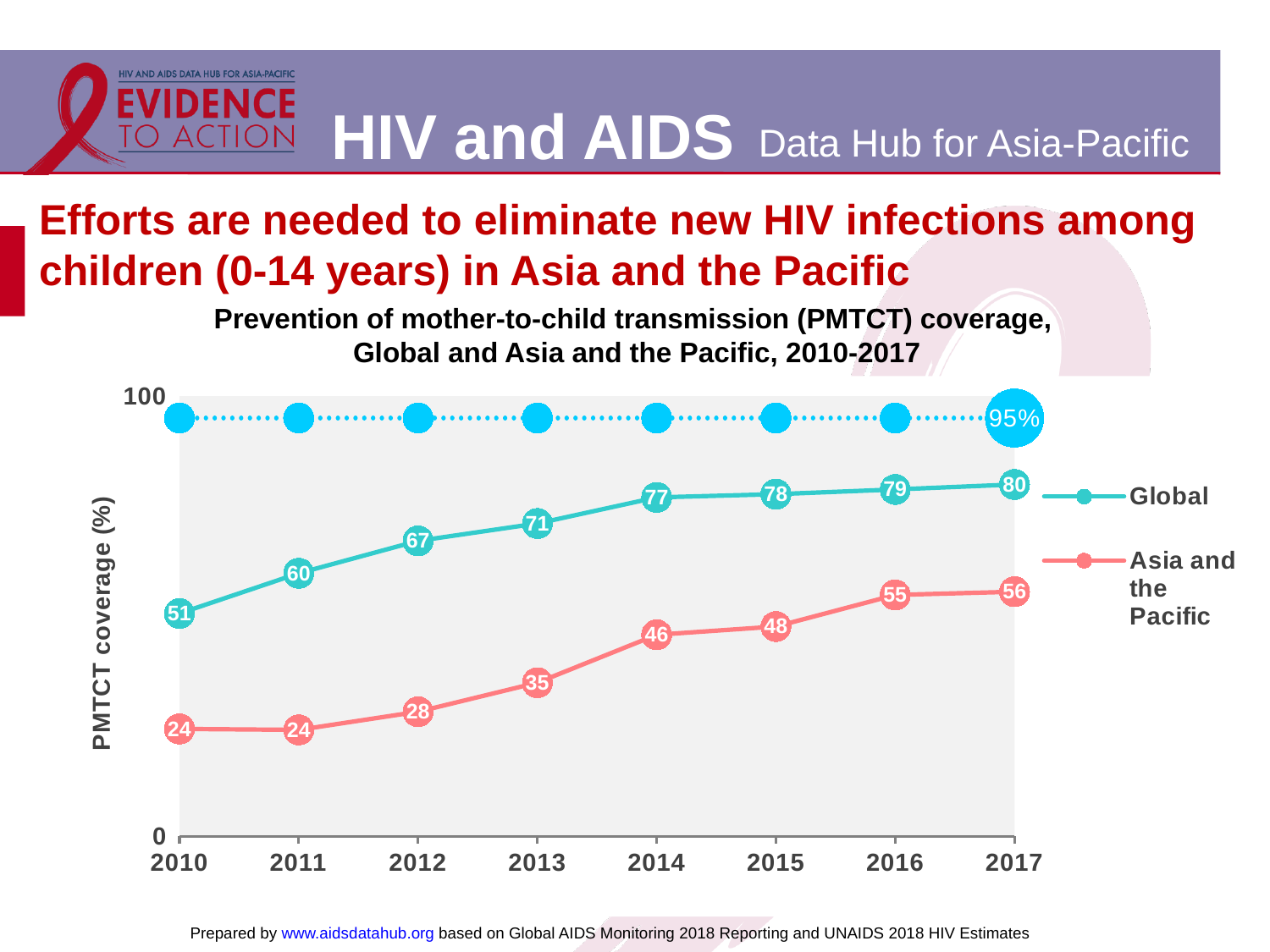
In which year is the Global series at its highest? 2017 What is the Global PMTCT coverage value in 2010? 51 What kind of chart is shown on the slide? Line chart By how much did the Asia and the Pacific value increase from 2010 to 2017? 32 In which years is the Asia and the Pacific series at its lowest? 2010 and 2011 What is the difference between the Global and Asia and the Pacific values in 2014? 31 What target percentage is marked by the dotted line at the top of the chart? 95% What is the Asia and the Pacific PMTCT coverage value in 2017? 56 How many years are shown on the x axis? 8 What is the Asia and the Pacific value in 2013? 35 Which series has the higher value in 2015, Global or Asia and the Pacific? Global How many series does the legend list? 2